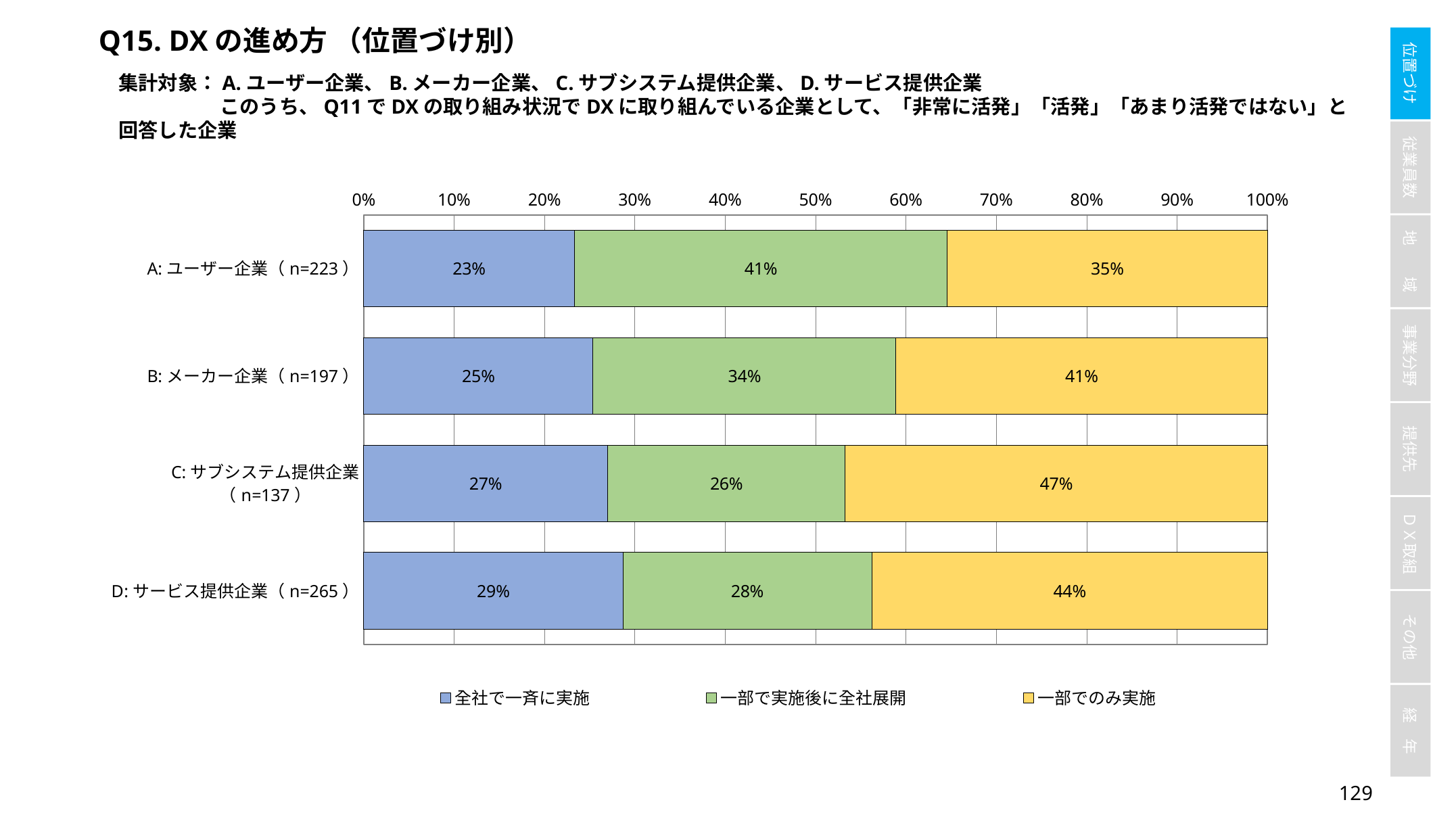
How many series does the legend list? 3 How many categories (company types) are plotted in the chart? 4 Which category has the lowest value for 全社で一斉に実施? A: ユーザー企業 What is the value of 一部でのみ実施 for C: サブシステム提供企業? 47% What colour represents 一部でのみ実施 in the chart? yellow What is the difference between the 一部でのみ実施 values for C: サブシステム提供企業 and A: ユーザー企業? 12% What is the value of 一部で実施後に全社展開 for B: メーカー企業? 34% What is the value of 全社で一斉に実施 for A: ユーザー企業? 23% What type of chart is shown on the slide? stacked bar chart Which is larger: the 一部で実施後に全社展開 value for B: メーカー企業 or for D: サービス提供企業? B: メーカー企業 Which category has the highest value for 一部で実施後に全社展開? A: ユーザー企業 What is the value of 全社で一斉に実施 for D: サービス提供企業? 29%